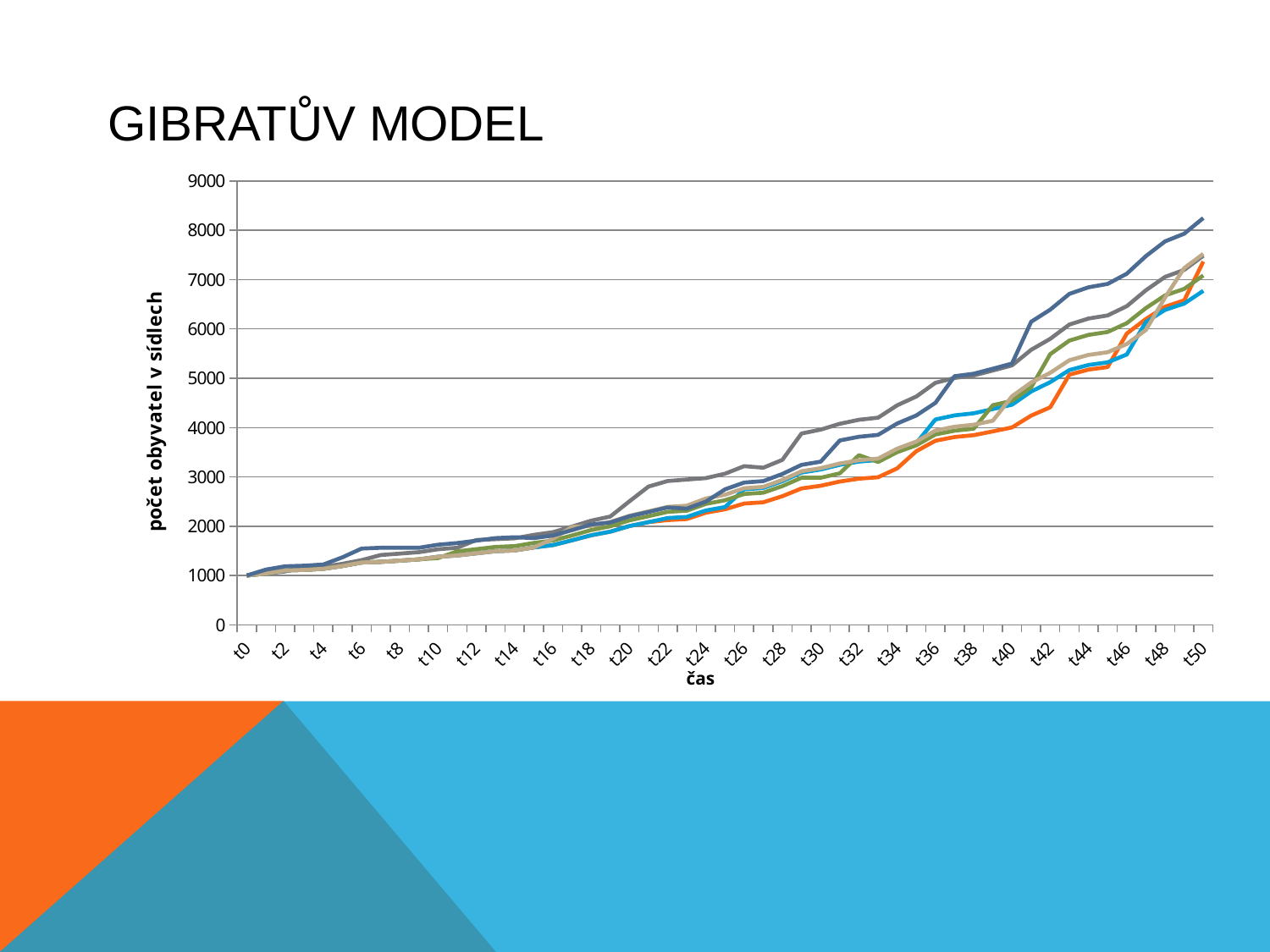
Is the value of the light blue line at t50 greater or less than 7000? less What is the label of the vertical axis? počet obyvatel v sídlech Which line has the lowest value at t50? the light blue line What is the title of the slide containing the chart? GIBRATŮV MODEL How many labelled tick marks are on the x axis (from t0 to t50)? 26 At what value do all the lines start at t0? 1000 Which line has the highest value at t50? the dark blue line What kind of chart is shown on the slide? line chart How many lines are plotted on the chart? 6 Is the value of the dark blue line at t50 greater or less than 8000? greater Do the plotted values rise or fall from t0 to t50? rise Is the value of the orange line at t42 greater or less than 5000? less